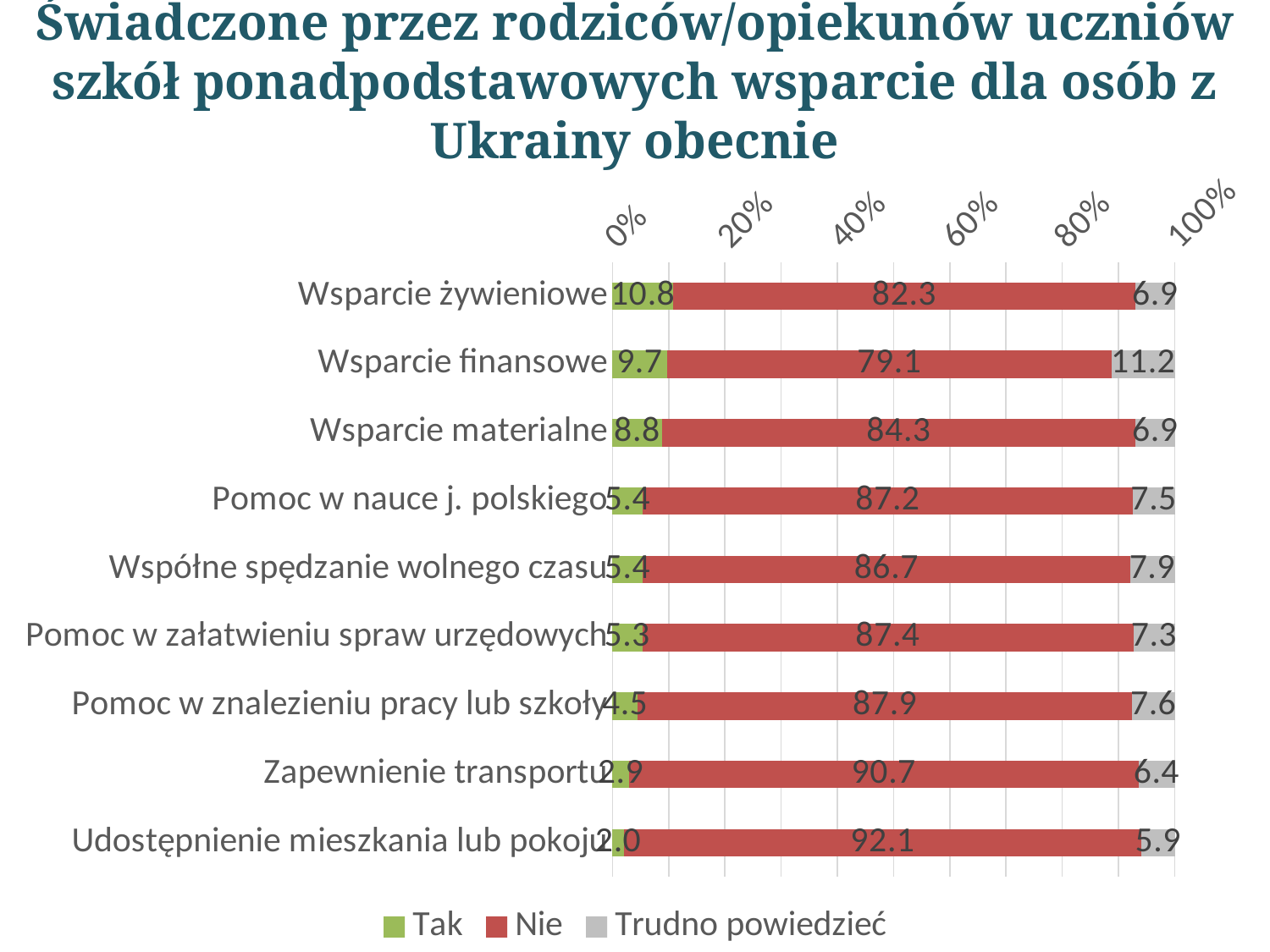
Which is larger: the "Trudno powiedzieć" value for Wsparcie finansowe or for Wsparcie materialne? Wsparcie finansowe What is the "Nie" value for Zapewnienie transportu? 90.7 What is the difference between the "Nie" values for Udostępnienie mieszkania lub pokoju and Wsparcie finansowe? 13.0 Is the "Nie" value for Wsparcie żywieniowe greater or less than 80%? greater Which category has the highest "Tak" value? Wsparcie żywieniowe What is the "Tak" value for Wsparcie żywieniowe? 10.8 Which category has the lowest "Tak" value? Udostępnienie mieszkania lub pokoju What kind of chart is shown on the slide? Stacked bar chart Which category has the highest "Nie" value? Udostępnienie mieszkania lub pokoju What is the "Trudno powiedzieć" value for Wsparcie finansowe? 11.2 How many series does the legend list? 3 How many categories are shown on the chart? 9